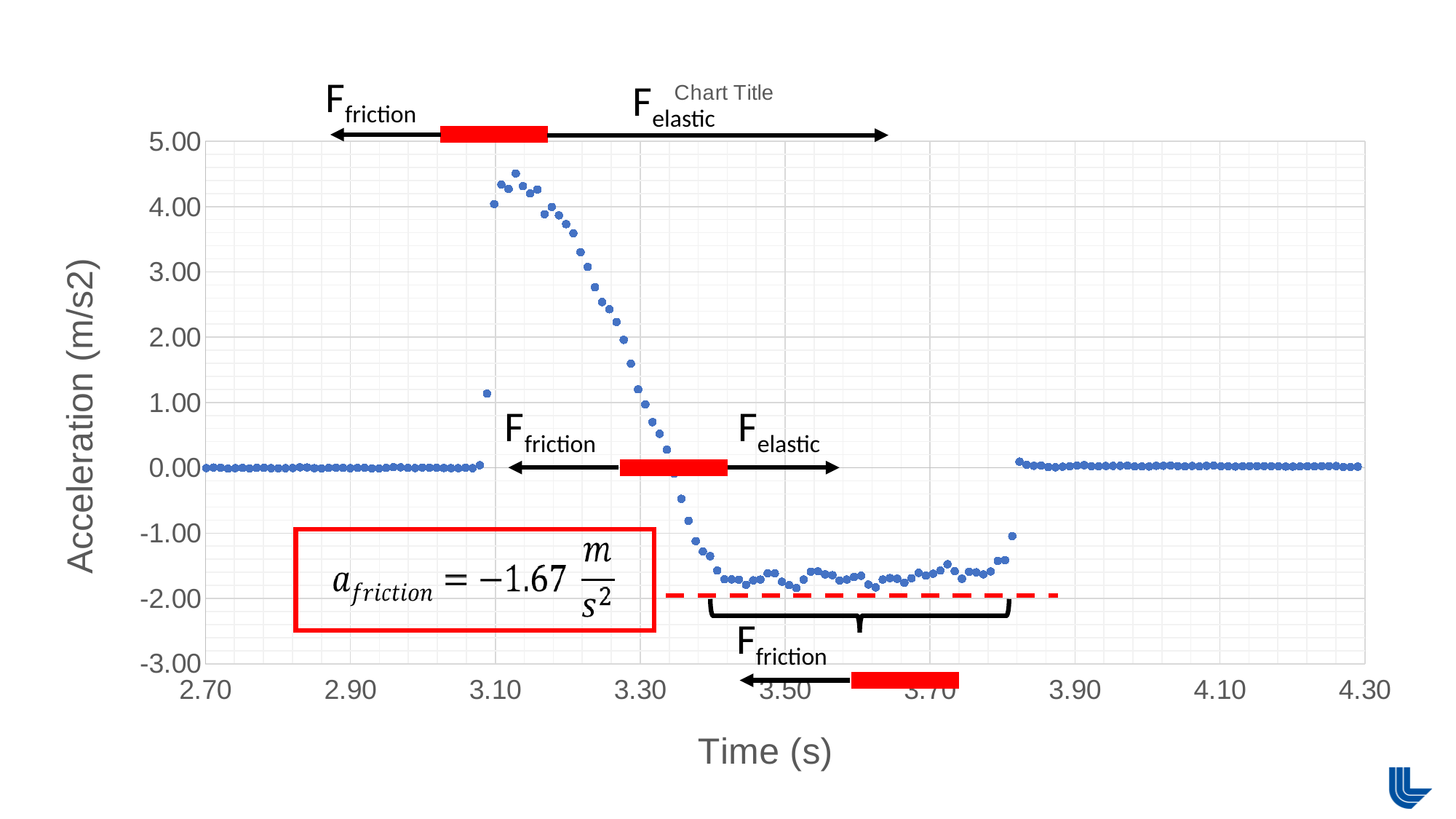
Is the acceleration value at time 4.10 s greater or less than -1.00? greater Is the lowest plotted acceleration value greater or less than -3.00? greater What is the highest tick value shown on the vertical axis? 5.00 Which is larger, the acceleration value at time 3.20 s or at time 3.60 s? 3.20 s What kind of chart is shown on the slide? scatter chart Is the highest plotted acceleration value greater or less than 4.00? greater What is the title of the vertical axis of the chart? Acceleration (m/s2) What value of a_friction is given in the red box on the chart? -1.67 m/s² What is the title of the horizontal axis of the chart? Time (s) Between time 3.10 s and 3.40 s, do the plotted acceleration values rise or fall? fall